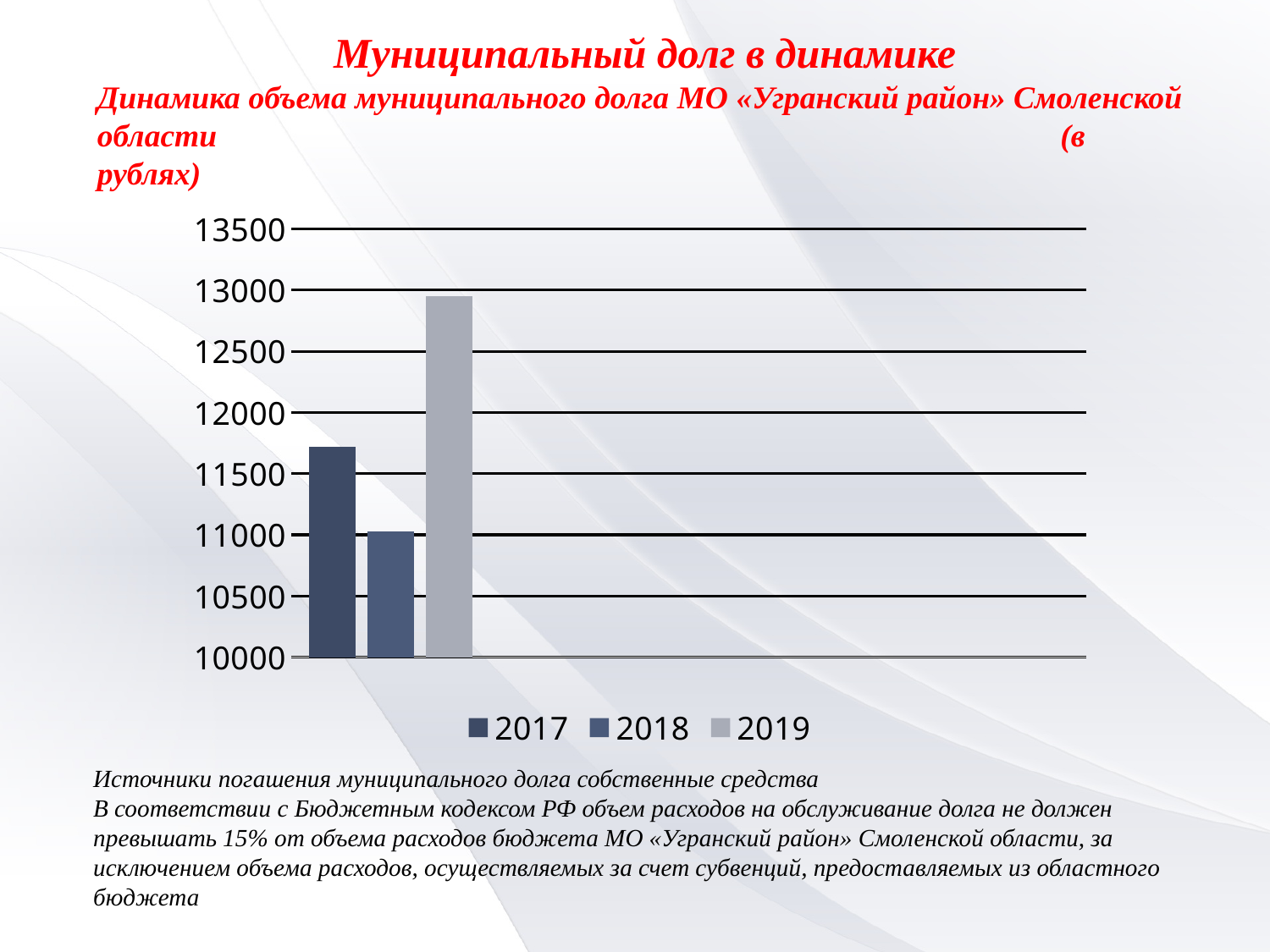
Which is larger, the value for 2019 or the value for 2017? 2019 Which year has the lowest municipal debt value? 2018 Is the value for 2019 greater or less than 12500? greater How many series does the legend list? 3 Which year has the highest municipal debt value? 2019 What kind of chart is shown on the slide? bar chart Does the value rise or fall from 2018 to 2019? rise Is the value for 2018 greater or less than 11500? less How many bars are plotted in the chart? 3 Is the value for 2017 greater or less than 11500? greater What are the entries listed in the chart legend? 2017, 2018, 2019 Which is larger, the value for 2017 or the value for 2018? 2017